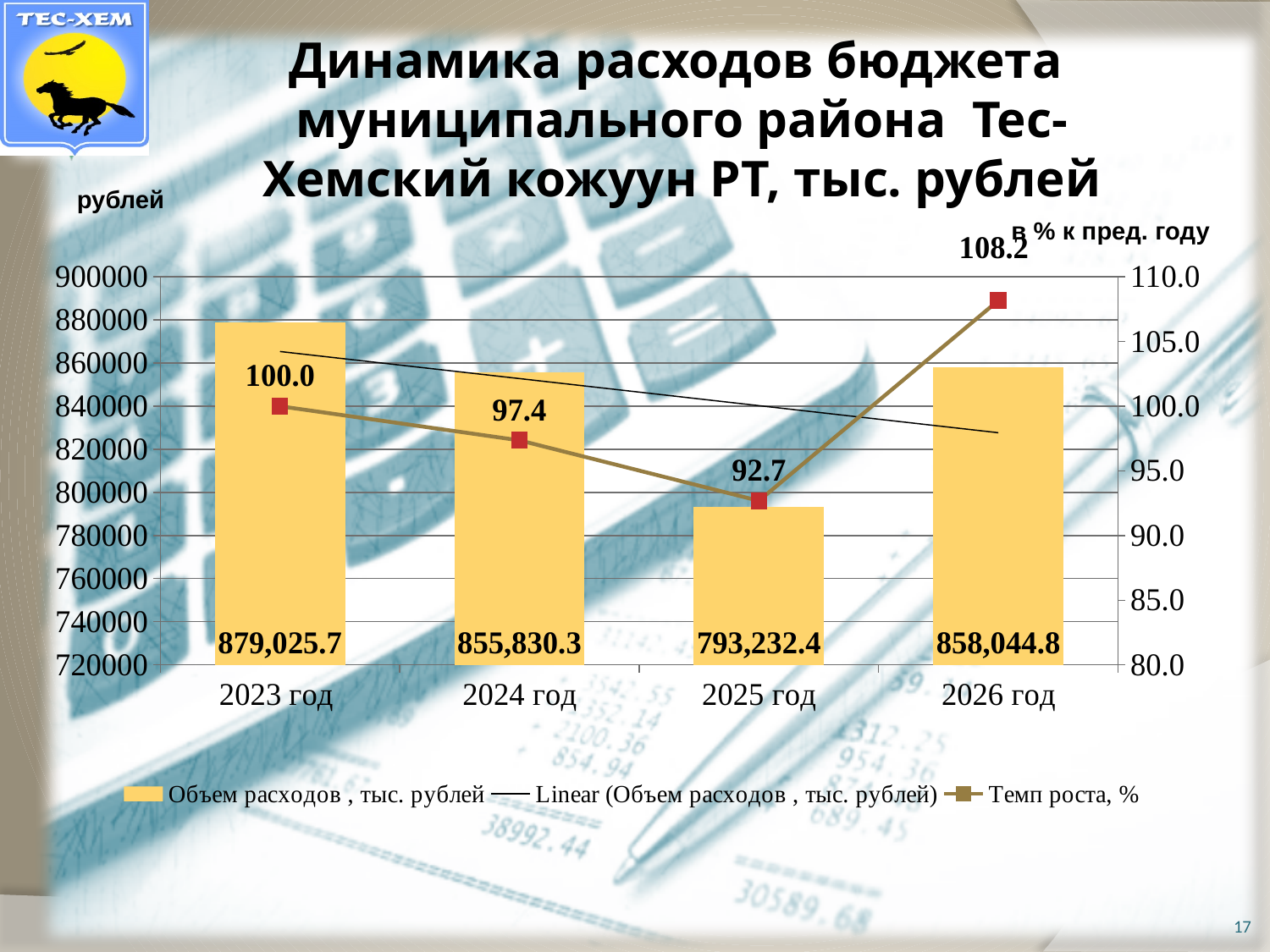
Which year has the highest Объем расходов, тыс. рублей? 2023 год What is the value of Объем расходов, тыс. рублей for 2025 год? 793,232.4 How many entries does the legend list? 3 Which is larger, Объем расходов for 2024 год or 2026 год? 2026 год What is the difference between Объем расходов for 2023 год and 2024 год? 23,195.4 Which year has the lowest Темп роста, %? 2025 год What is the Темп роста, % value for 2024 год? 97.4 What is the value of Объем расходов, тыс. рублей for 2023 год? 879,025.7 How many years are shown on the x axis? 4 What is the Темп роста, % value for 2026 год? 108.2 Does Темп роста, % rise or fall from 2023 год to 2025 год? fall Is the Объем расходов value for 2025 год greater or less than 800000? less